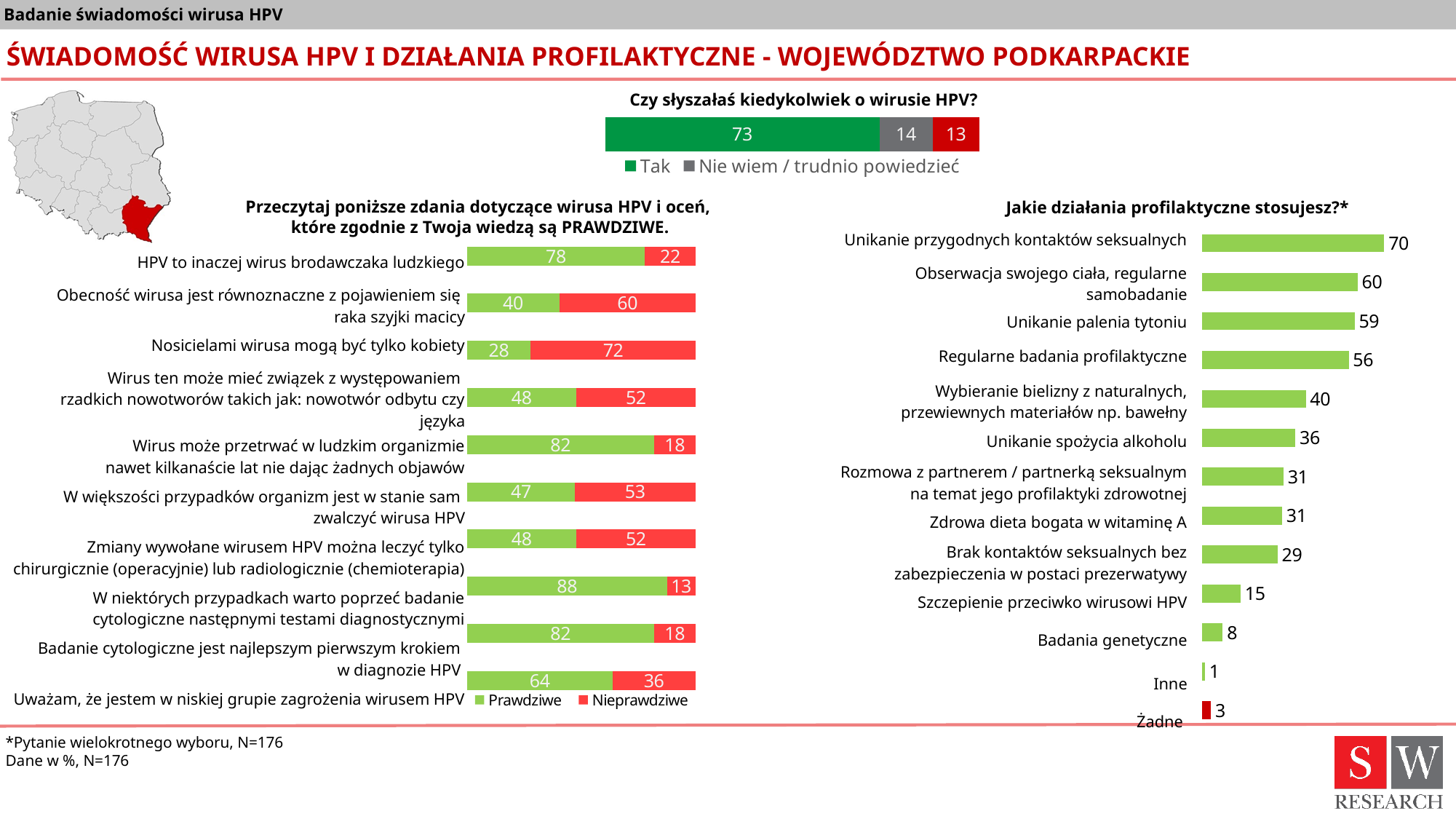
In the chart 'Jakie działania profilaktyczne stosujesz?*', what is the difference between 'Unikanie przygodnych kontaktów seksualnych' and 'Regularne badania profilaktyczne'? 14 In the chart 'Przeczytaj poniższe zdania dotyczące wirusa HPV...', what is the 'Prawdziwe' value for 'HPV to inaczej wirus brodawczaka ludzkiego'? 78 In the chart 'Przeczytaj poniższe zdania dotyczące wirusa HPV...', what is the 'Nieprawdziwe' value for 'Nosicielami wirusa mogą być tylko kobiety'? 72 In the chart 'Jakie działania profilaktyczne stosujesz?*', what is the value for 'Unikanie palenia tytoniu'? 59 In the chart 'Czy słyszałaś kiedykolwiek o wirusie HPV?', what is the value for 'Nie wiem / trudno powiedzieć'? 14 How many series does the legend of the chart 'Przeczytaj poniższe zdania dotyczące wirusa HPV...' list? 2 How many categories are shown in the chart 'Jakie działania profilaktyczne stosujesz?*'? 13 In the chart 'Jakie działania profilaktyczne stosujesz?*', which is larger: 'Unikanie spożycia alkoholu' or 'Szczepienie przeciwko wirusowi HPV'? Unikanie spożycia alkoholu In the chart 'Jakie działania profilaktyczne stosujesz?*', which category has the highest value? Unikanie przygodnych kontaktów seksualnych In the chart 'Jakie działania profilaktyczne stosujesz?*', which category has the lowest value? Inne In the chart 'Czy słyszałaś kiedykolwiek o wirusie HPV?', what is the value for 'Tak'? 73 What type of chart is 'Jakie działania profilaktyczne stosujesz?*'? Bar chart